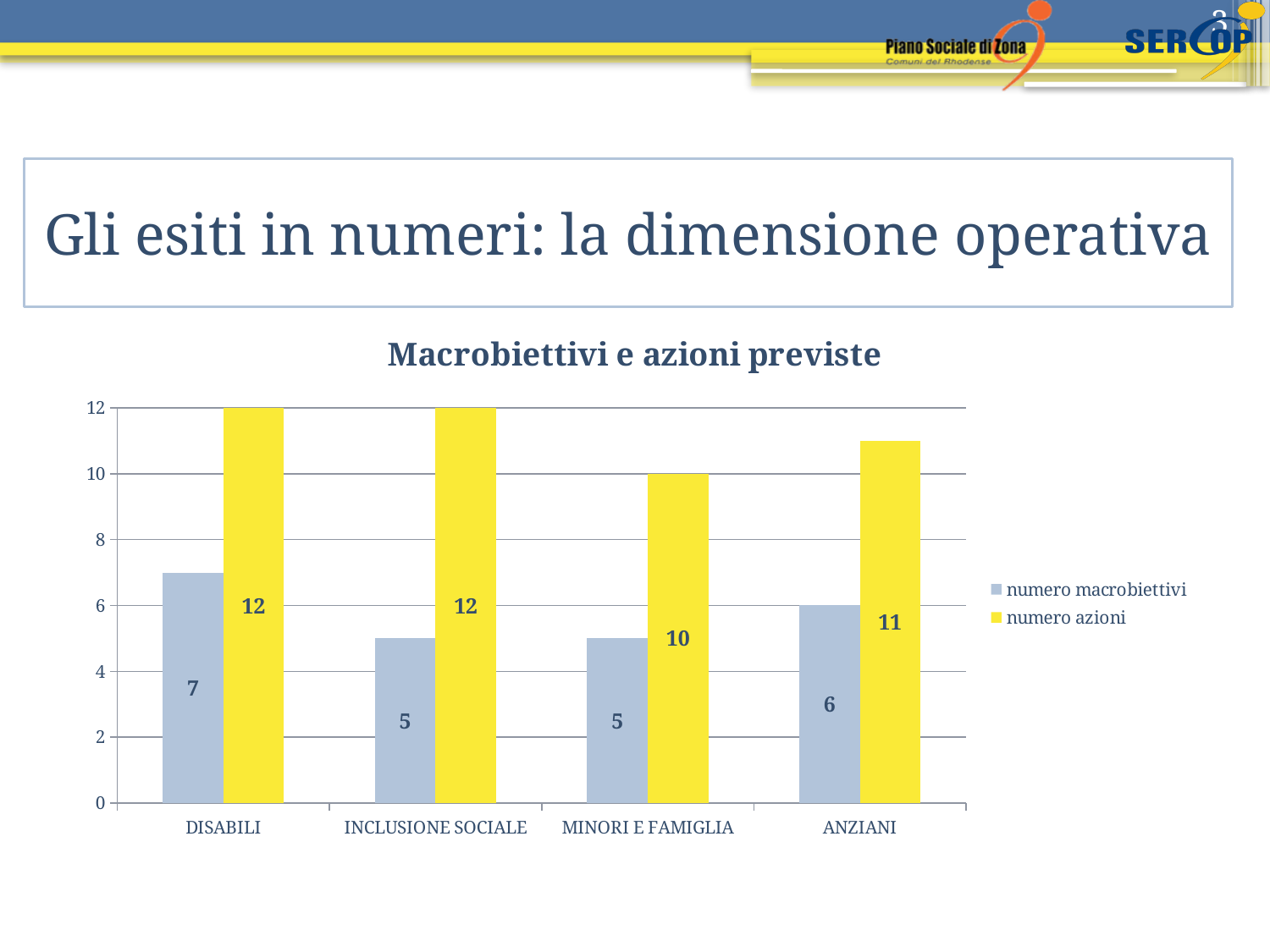
What is the difference between numero azioni and numero macrobiettivi for INCLUSIONE SOCIALE? 7 Which colour represents numero azioni in the chart? yellow What is the value of numero macrobiettivi for DISABILI? 7 What is the title of the chart? Macrobiettivi e azioni previste What kind of chart is shown on the slide? bar chart Which category has the highest value for numero macrobiettivi? DISABILI How many categories are shown on the x axis? 4 What is the value of numero azioni for MINORI E FAMIGLIA? 10 What is the value of numero azioni for ANZIANI? 11 Which category has the lowest value for numero azioni? MINORI E FAMIGLIA How many series does the legend list? 2 Which is larger: numero azioni for ANZIANI or numero azioni for MINORI E FAMIGLIA? numero azioni for ANZIANI